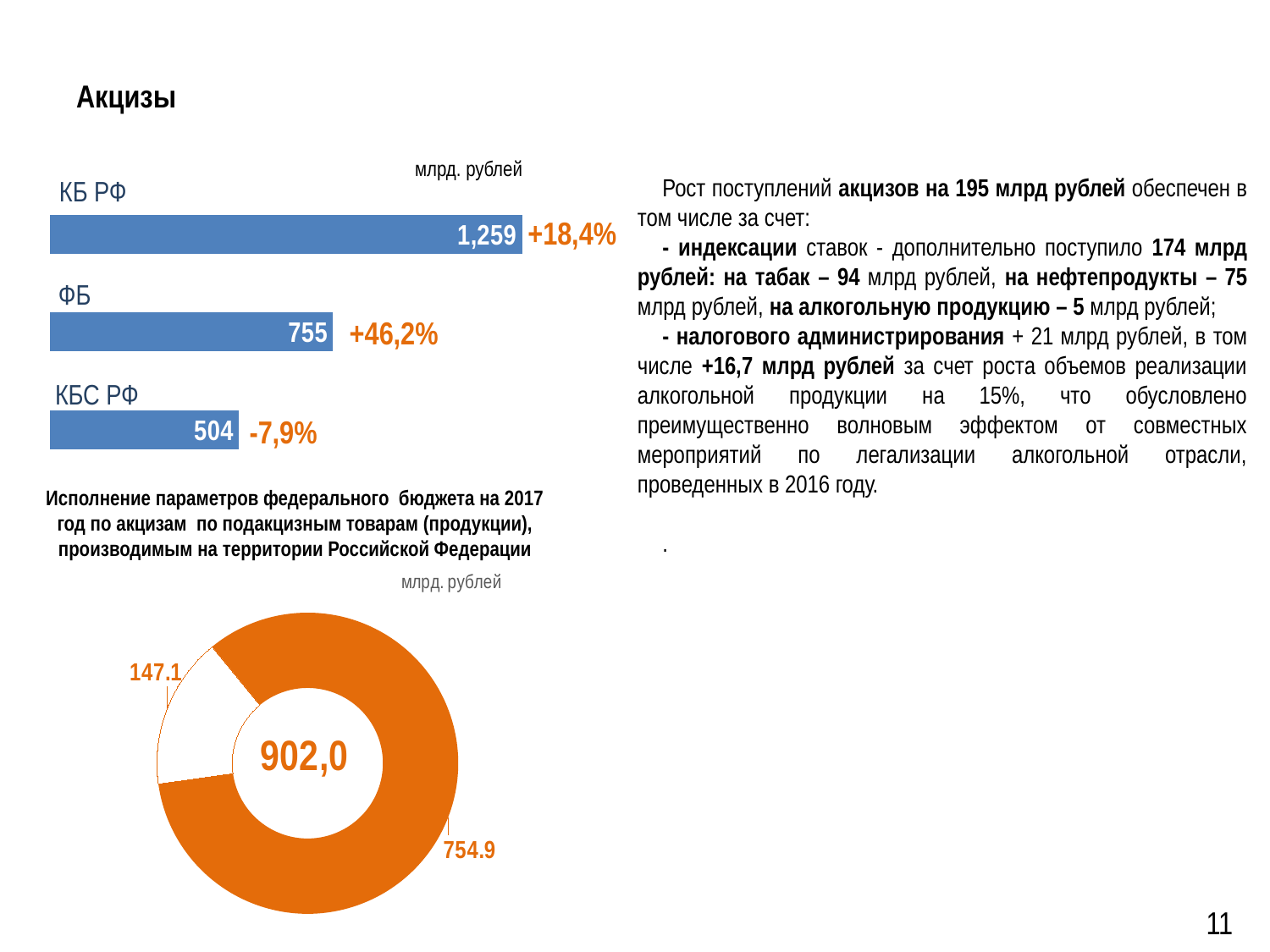
In the bottom doughnut chart, what is the difference between the two segment values? 607.8 In the top bar chart, what is the value for КБС РФ? 504 In the top bar chart, how many bars are shown? 3 In the bottom doughnut chart, what total value is shown in the centre? 902,0 In the top bar chart, what percentage change is shown next to the ФБ bar? +46,2% In the top bar chart, what is the value for ФБ? 755 In the top bar chart, what is the difference between the values for КБ РФ and ФБ? 504 In the top bar chart, what is the value for КБ РФ? 1,259 What kind of chart is the top-left chart on the slide? Bar chart In the top bar chart, which category has the lowest value? КБС РФ In the top bar chart, which category has the highest value? КБ РФ In the bottom doughnut chart, what is the value of the larger (orange) segment? 754.9